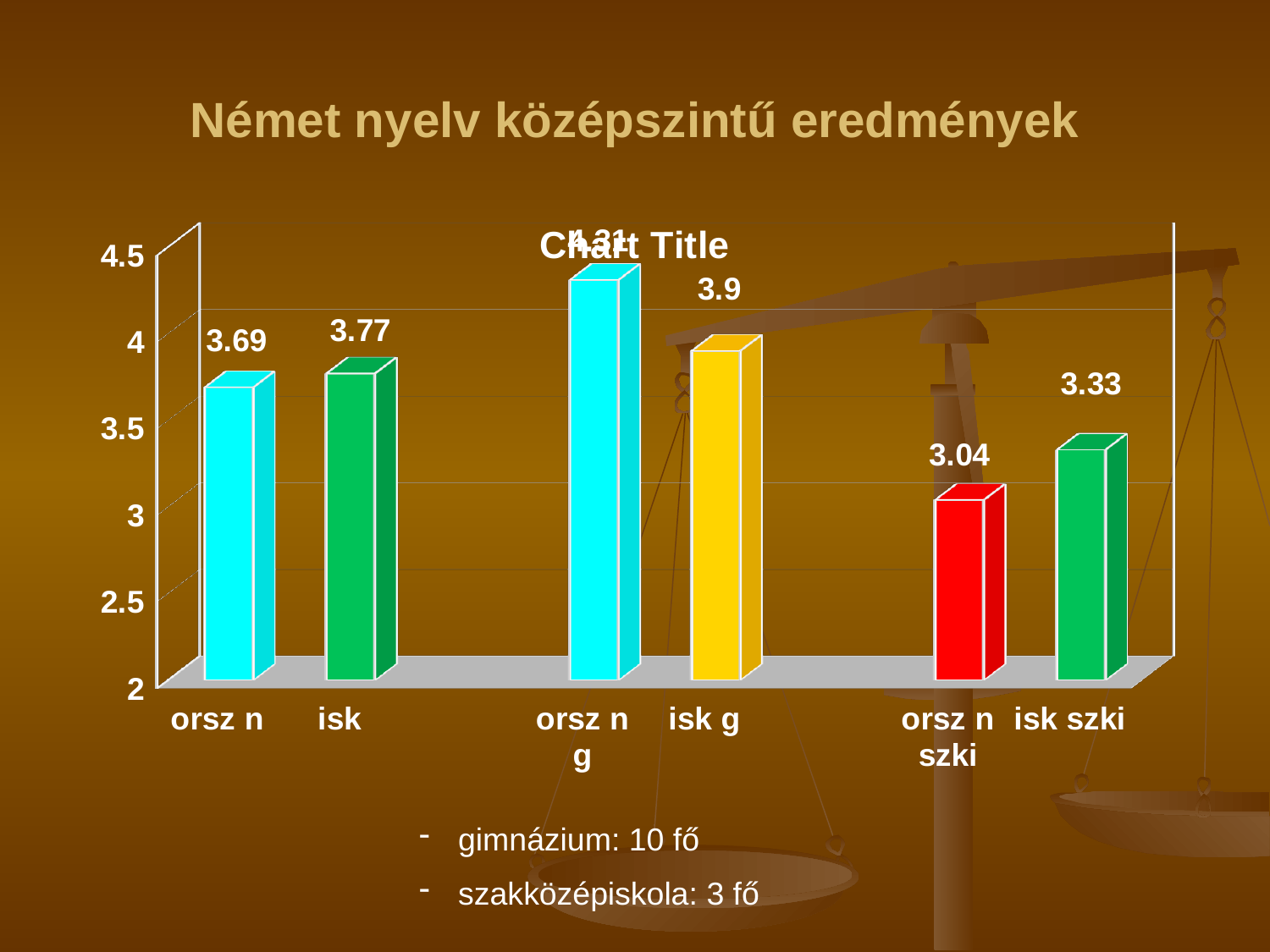
What is the value for "orsz n szki"? 3.04 What is the difference between the values for "isk szki" and "orsz n szki"? 0.29 Which is larger, the value for "isk g" or the value for "isk"? isk g What is the value for "isk szki"? 3.33 What is the value for "isk"? 3.77 What is the difference between the values for "isk" and "orsz n"? 0.08 What is the value for "orsz n"? 3.69 What is the value for "isk g"? 3.9 Which category has the lowest value? orsz n szki How many categories are shown on the x axis? 6 Is the value for "orsz n g" greater or less than 4? greater Which category has the highest value? orsz n g